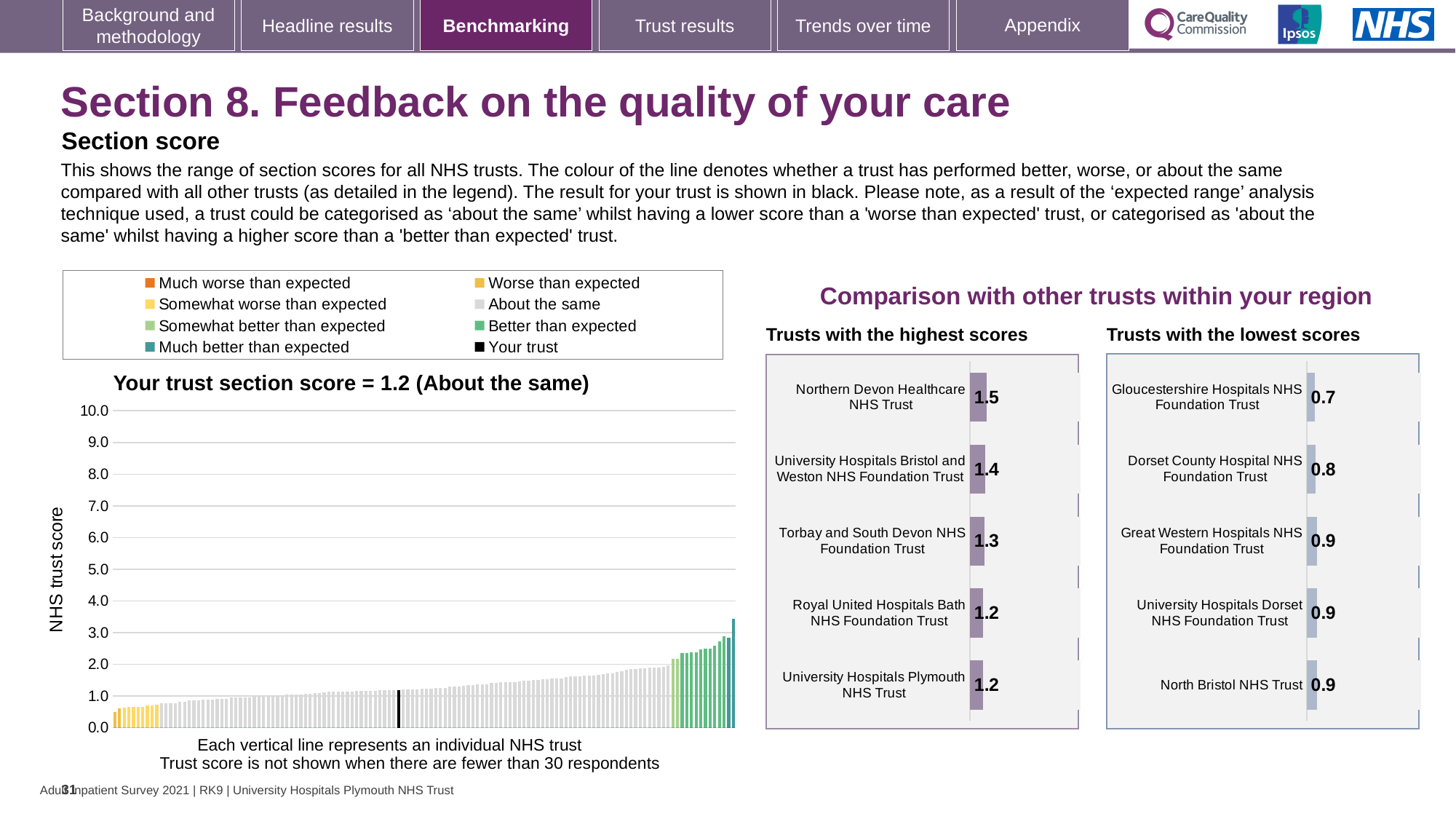
What kind of chart is the 'Your trust section score' chart? bar chart In the 'Trusts with the lowest scores' chart, which has the larger score: Dorset County Hospital NHS Foundation Trust or North Bristol NHS Trust? North Bristol NHS Trust In the 'Your trust section score' chart, is the tallest bar greater or less than 4.0? less What is the section score for your trust shown in the title of the 'Your trust section score' chart? 1.2 In the 'Trusts with the highest scores' chart, which trust has the highest score? Northern Devon Healthcare NHS Trust In the 'Trusts with the highest scores' chart, what is the score for Northern Devon Healthcare NHS Trust? 1.5 In the 'Trusts with the highest scores' chart, how many trusts are listed? 5 In the 'Your trust section score' chart, what is the label on the y axis? NHS trust score In the 'Trusts with the lowest scores' chart, what is the score for Gloucestershire Hospitals NHS Foundation Trust? 0.7 In the 'Trusts with the lowest scores' chart, which trust has the lowest score? Gloucestershire Hospitals NHS Foundation Trust In the 'Trusts with the highest scores' chart, what is the difference between the scores of Northern Devon Healthcare NHS Trust and University Hospitals Plymouth NHS Trust? 0.3 In the 'Your trust section score' chart, what colour is used for your trust according to the legend? black